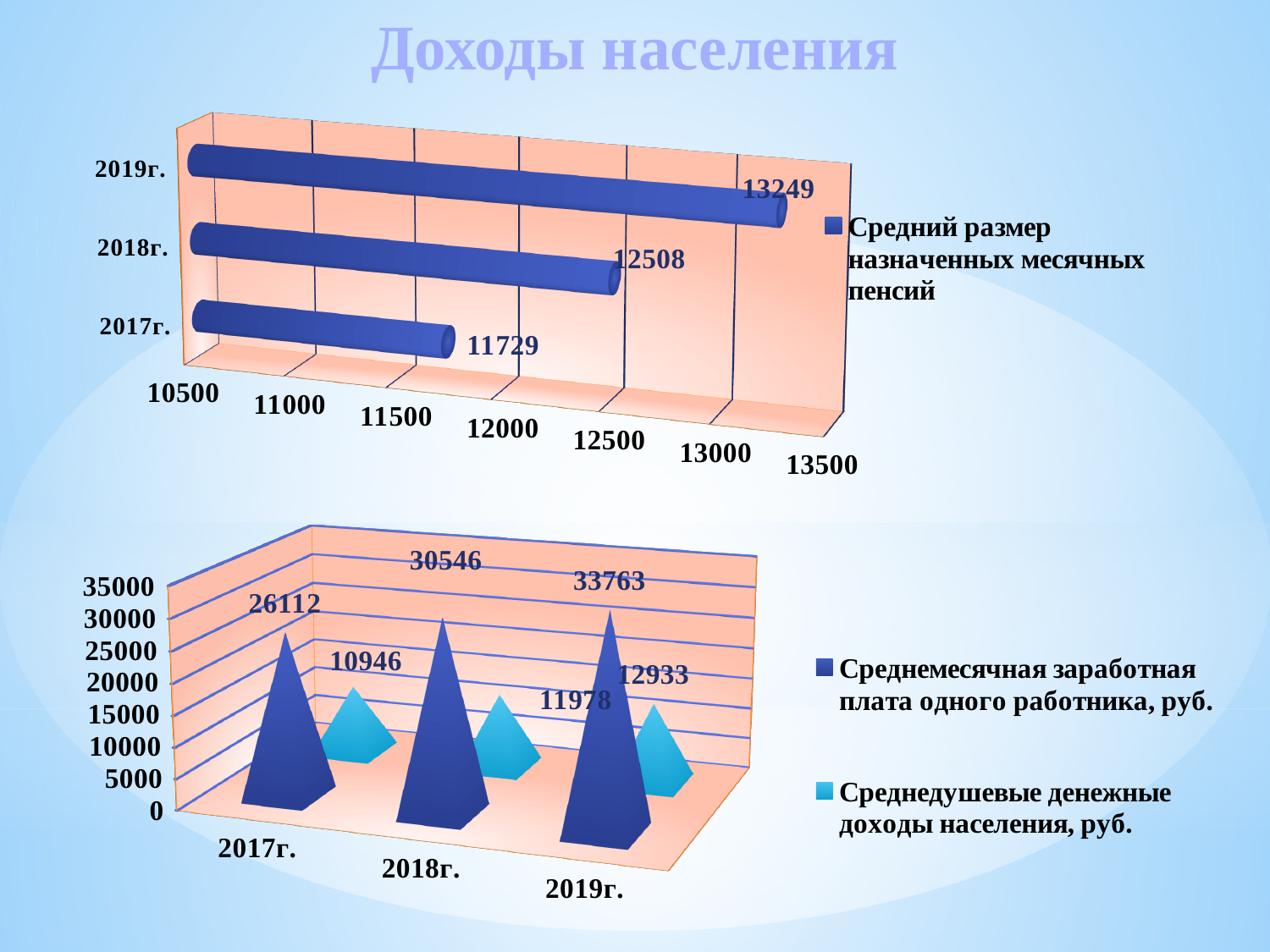
In the top chart, what is the average monthly pension for 2019г.? 13249 In the bottom chart, do the per capita income values rise or fall from 2017г. to 2019г.? rise In the bottom chart, what is the per capita income (Среднедушевые денежные доходы населения) for 2019г.? 12933 In the top chart, what is the difference between the 2019г. and 2018г. values? 741 In the bottom chart, which year has the highest average monthly wage? 2019г. In the top chart, what is the value for 2017г.? 11729 In the top chart, how many years are shown? 3 How many series does the legend of the bottom chart list? 2 What kind of chart is the top chart? bar chart In the bottom chart, what is the average monthly wage (Среднемесячная заработная плата одного работника) for 2018г.? 30546 In the bottom chart, what is the difference between the wage and per capita income values for 2017г.? 15166 In the top chart, which year has the lowest average pension? 2017г.